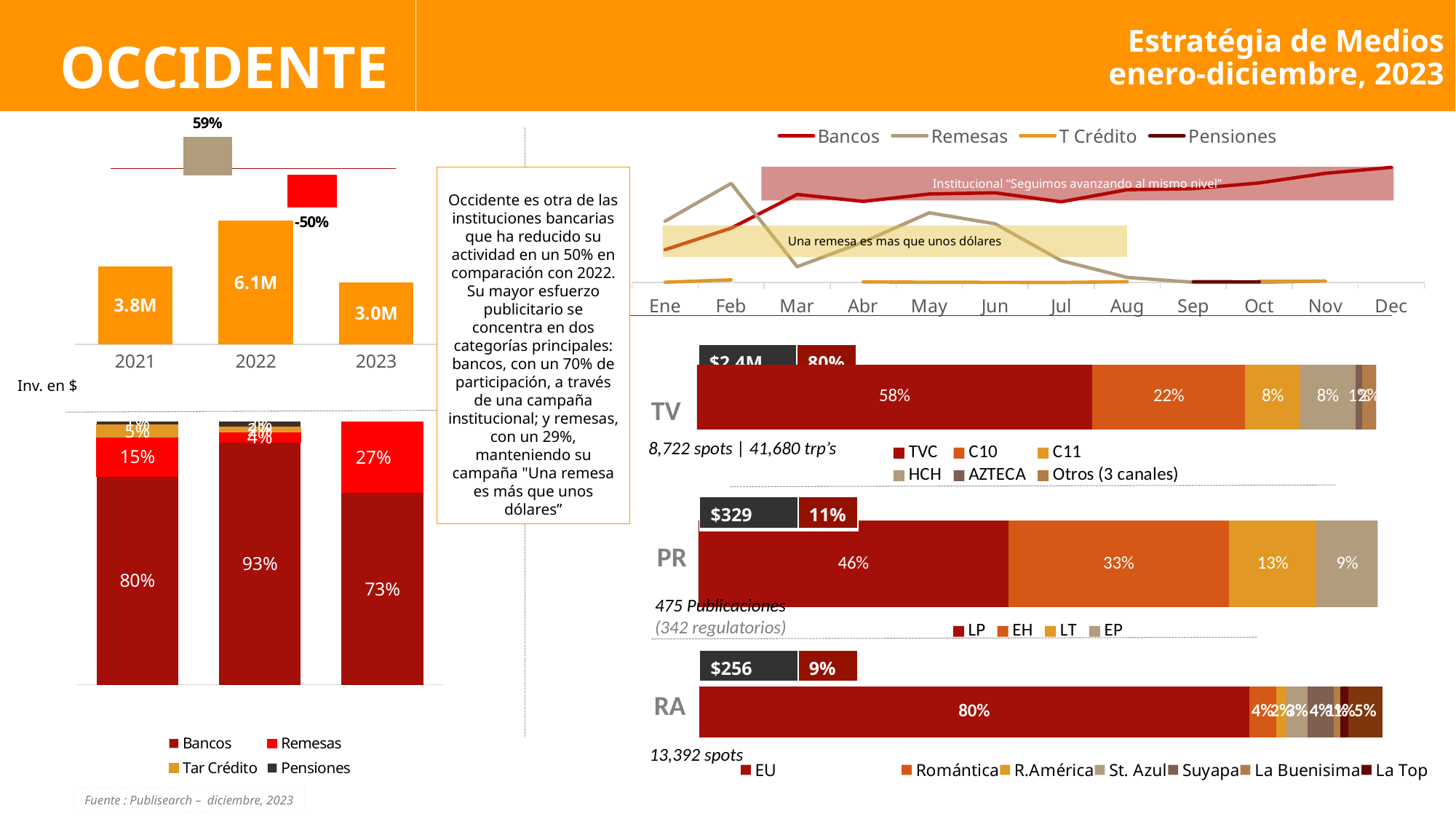
In the stacked bar chart at the bottom left, how many series does the legend list? 4 In the PR stacked bar on the right, which is larger, LT or EP? LT In the TV stacked bar on the right, what share does TVC have? 58% In the line chart at the top right, how many series does the legend list? 4 In the stacked bar chart at the bottom left, what share does Bancos have in 2022? 93% In the PR stacked bar on the right, what is the difference between the LP share and the EH share? 13% In the 'Inv. en $' bar chart on the left, which year has the lowest investment? 2023 In the 'Inv. en $' bar chart on the left, which year has the highest investment? 2022 In the stacked bar chart at the bottom left, what share does Remesas have in 2023? 27% In the 'Inv. en $' bar chart on the left, how many years are shown? 3 In the 'Inv. en $' bar chart on the left, what is the value for 2022? 6.1M In the RA stacked bar on the right, which station has the largest share? EU